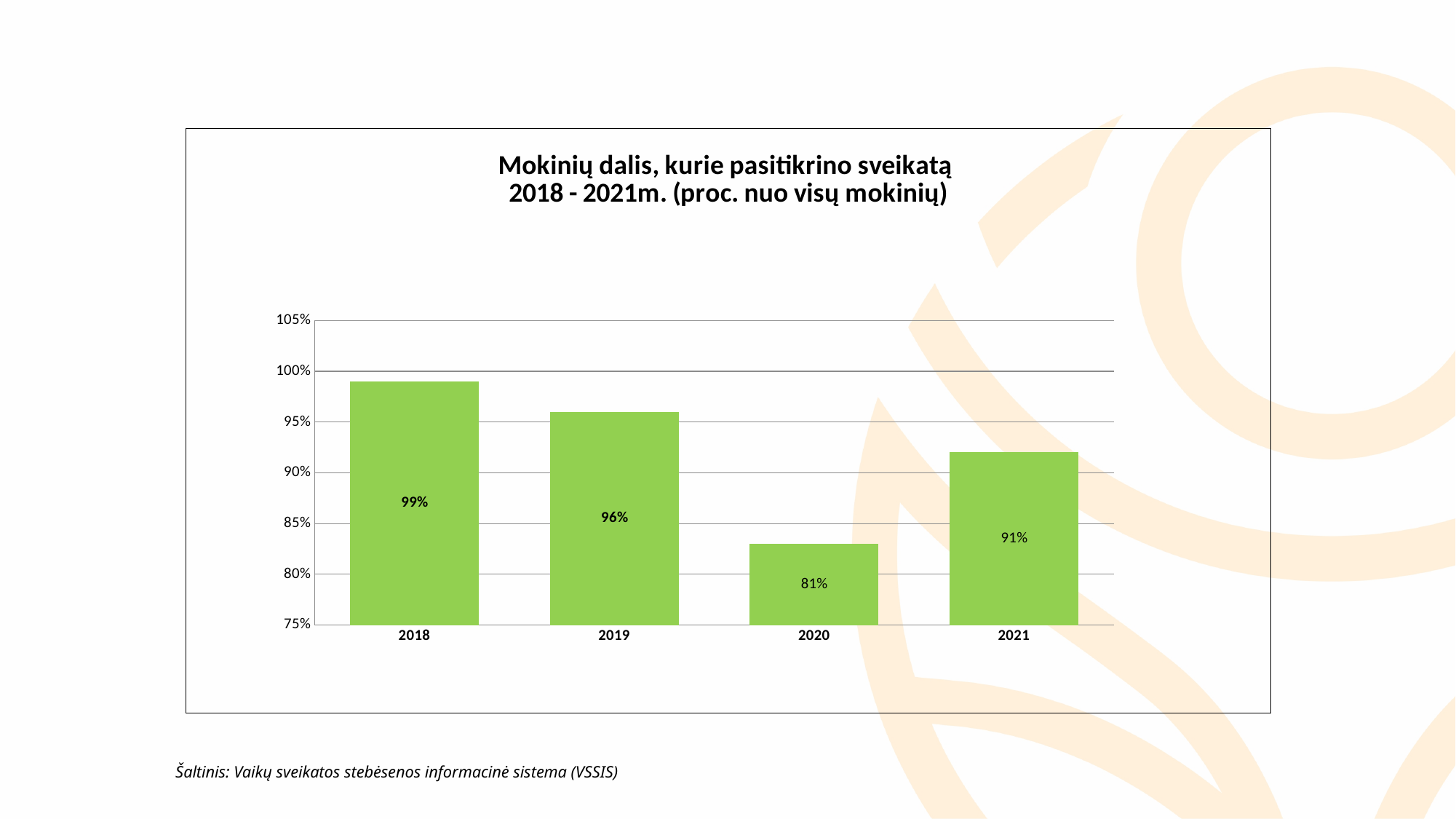
What is the difference between the values for 2018 and 2020? 18% Is the value for 2020 greater or less than 85%? less What is the value for 2021? 91% Which year has the lowest value? 2020 Which year has the highest value? 2018 What kind of chart is shown on the slide? bar chart Which is larger, the value for 2019 or the value for 2021? 2019 How many years are shown on the x axis? 4 What is the value for 2020? 81% What is the value for 2018? 99% What is the difference between the values for 2019 and 2021? 5% What is the title of the chart? Mokinių dalis, kurie pasitikrino sveikatą 2018 - 2021m. (proc. nuo visų mokinių)